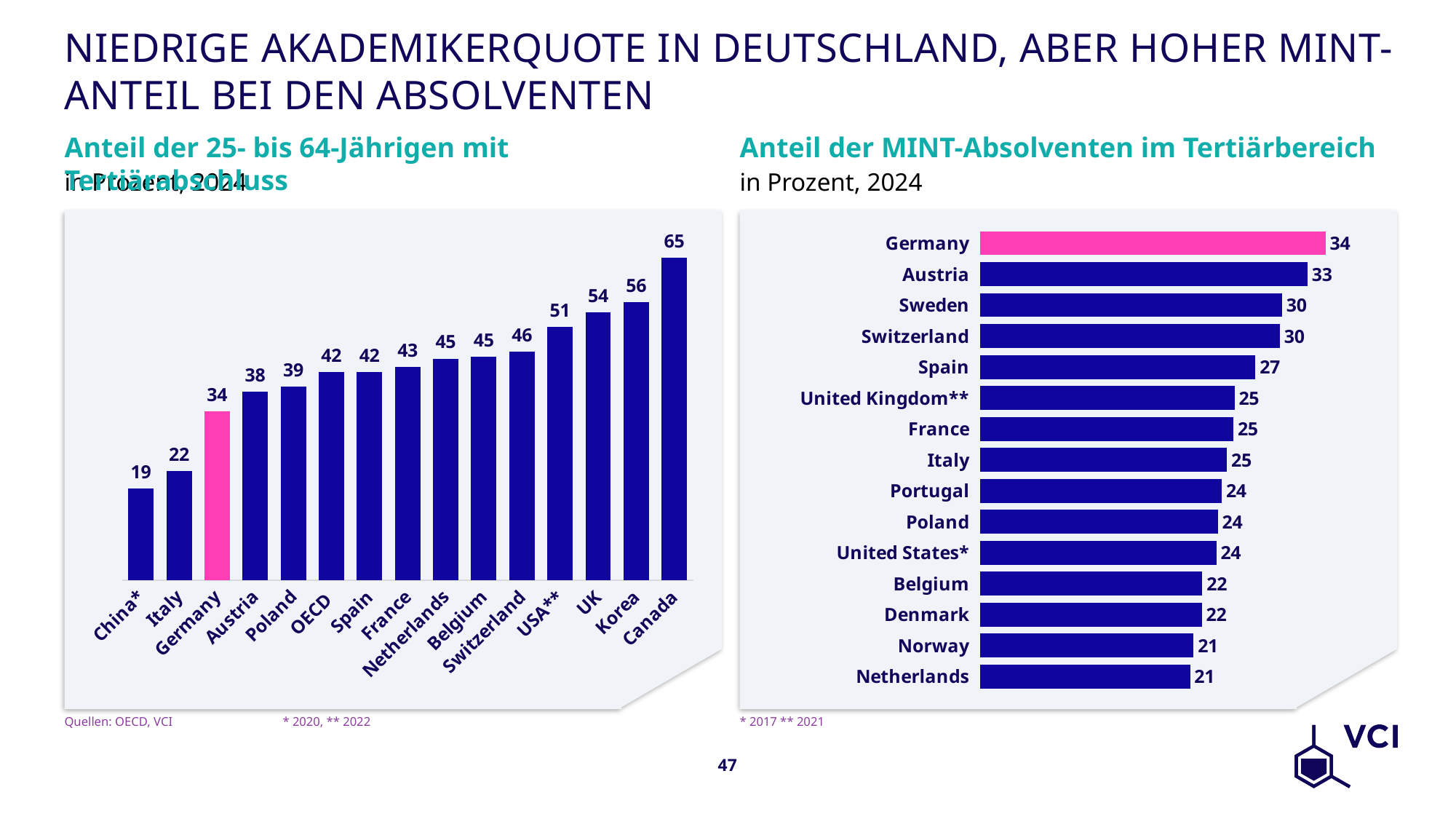
In the chart titled 'Anteil der MINT-Absolventen im Tertiärbereich', what is the difference between the values for Germany and Netherlands? 13 In the left chart, what is the value for Germany? 34 In the left chart, what is the difference between the values for Canada and Germany? 31 How many categories are shown in the left chart? 15 In the chart titled 'Anteil der MINT-Absolventen im Tertiärbereich', what is the value for Austria? 33 Do the values in the left chart rise or fall from left to right along the x axis? rise In the left chart, what is the value for Canada? 65 In the left chart, which category has the lowest value? China* In the chart titled 'Anteil der MINT-Absolventen im Tertiärbereich', which bar is highlighted in pink? Germany In the left chart, which is larger, the value for Korea or the value for UK? Korea In the chart titled 'Anteil der MINT-Absolventen im Tertiärbereich', which category has the highest value? Germany What kind of chart is the chart titled 'Anteil der MINT-Absolventen im Tertiärbereich'? bar chart